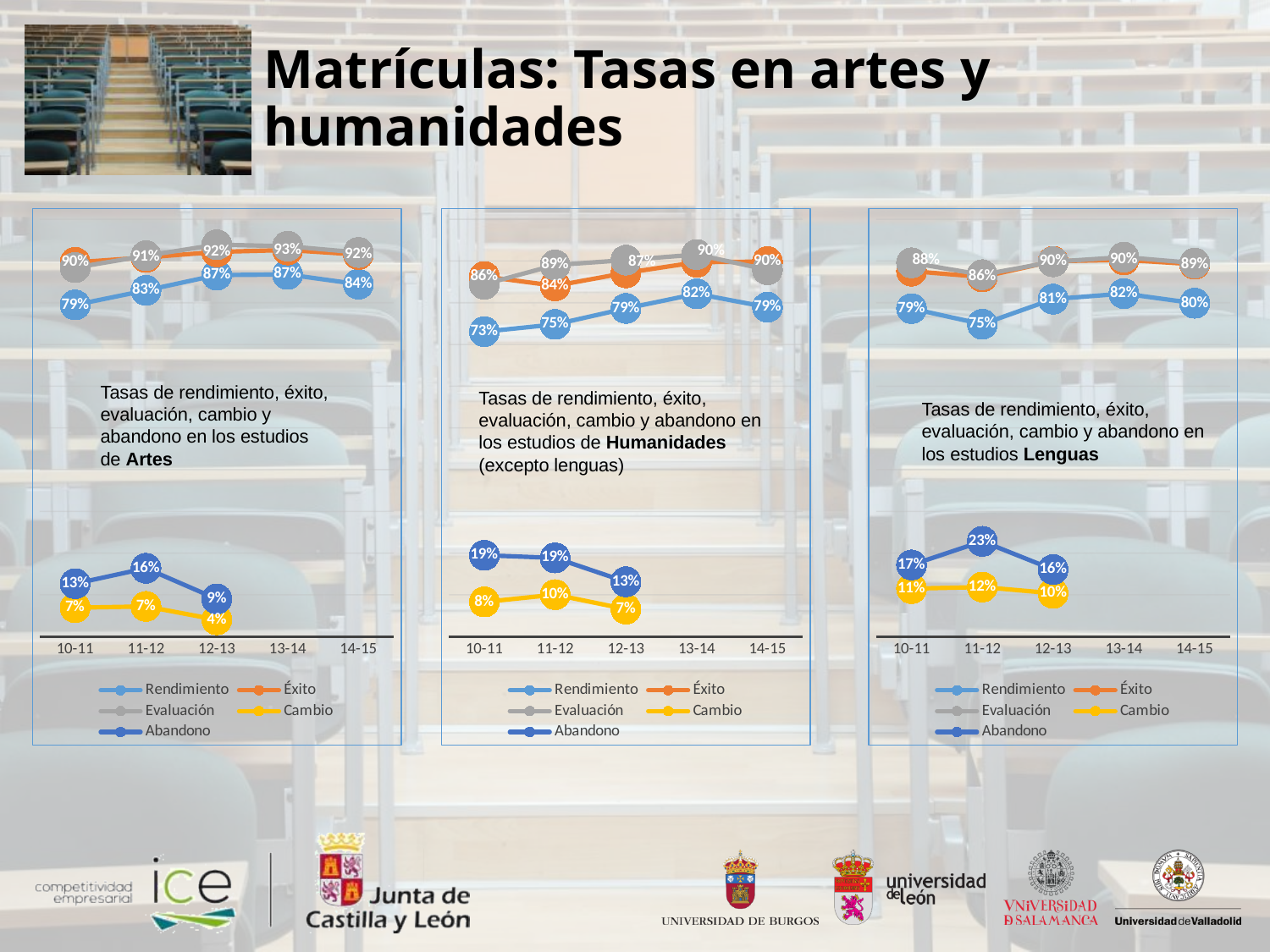
In the Humanidades chart (middle), what is the Rendimiento value for 10-11? 73% In the Artes chart (left), what is the Abandono value for 11-12? 16% In the Lenguas chart (right), which is larger, the Cambio value for 11-12 or for 12-13? 11-12 In the Lenguas chart (right), what is the Abandono value for 11-12? 23% In the Lenguas chart (right), in which academic year is Rendimiento lowest? 11-12 How many series does the legend of the Artes chart (left) list? 5 In the Artes chart (left), what is the Cambio value for 12-13? 4% In the Humanidades chart (middle), in which academic year is Rendimiento highest? 13-14 In the Artes chart (left), what is the Rendimiento value for 12-13? 87% How many academic years are shown on the x axis of the Humanidades chart (middle)? 5 In the Humanidades chart (middle), what is the difference between the Abandono values for 11-12 and 12-13? 6% What kind of chart is used in the Lenguas chart (right)? Line chart